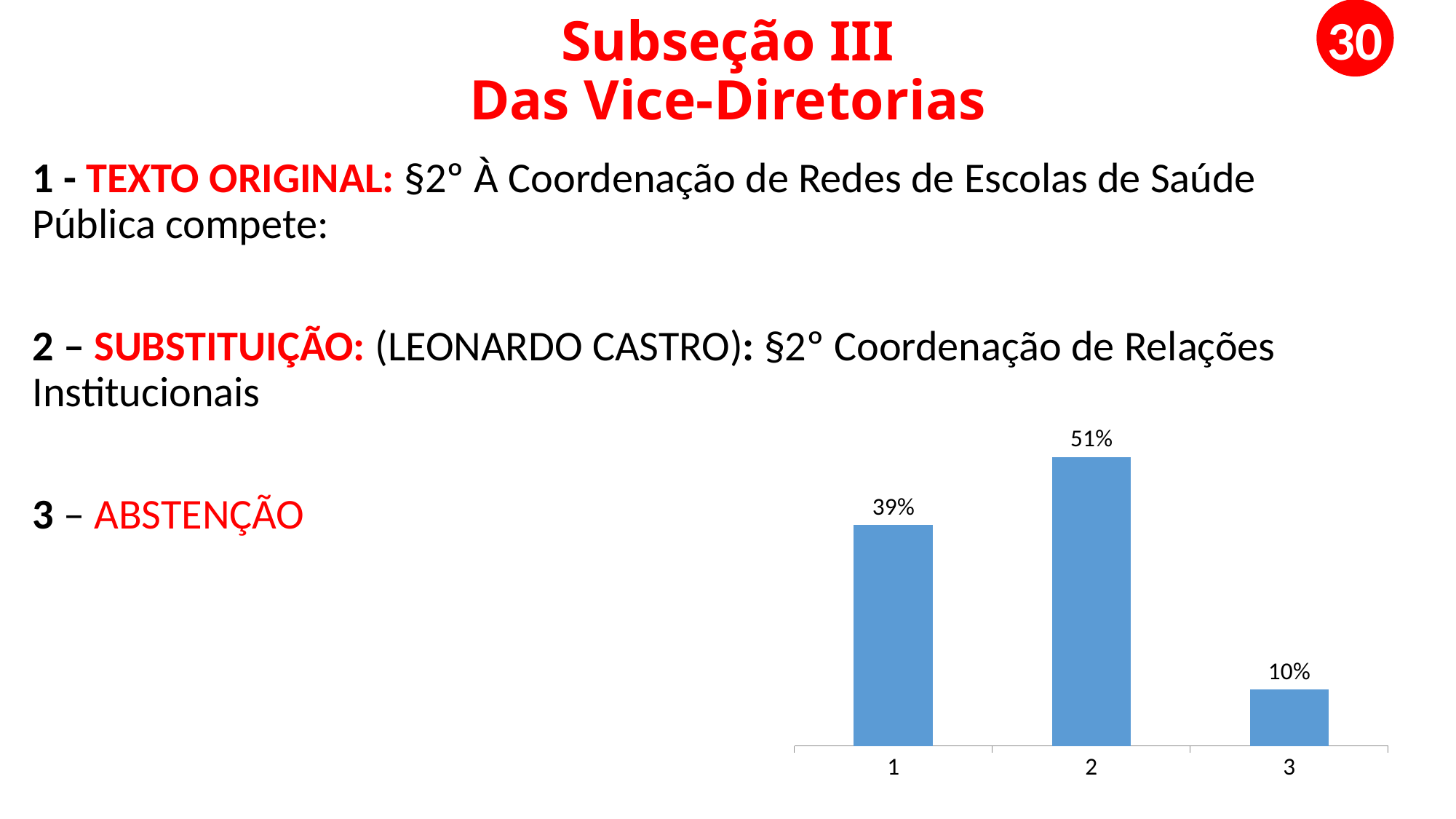
What is the total of the three values shown in the chart? 100% Which category has the lowest value? 3 What is the difference between the values for category 1 and category 3? 29% What is the value for category 1? 39% What colour are the bars in the chart? blue Which is larger, the value for category 1 or category 3? 1 What kind of chart is shown on the slide? bar chart What is the value for category 3? 10% What is the value for category 2? 51% How many categories are shown in the chart? 3 Which category has the highest value? 2 What is the difference between the values for category 2 and category 1? 12%